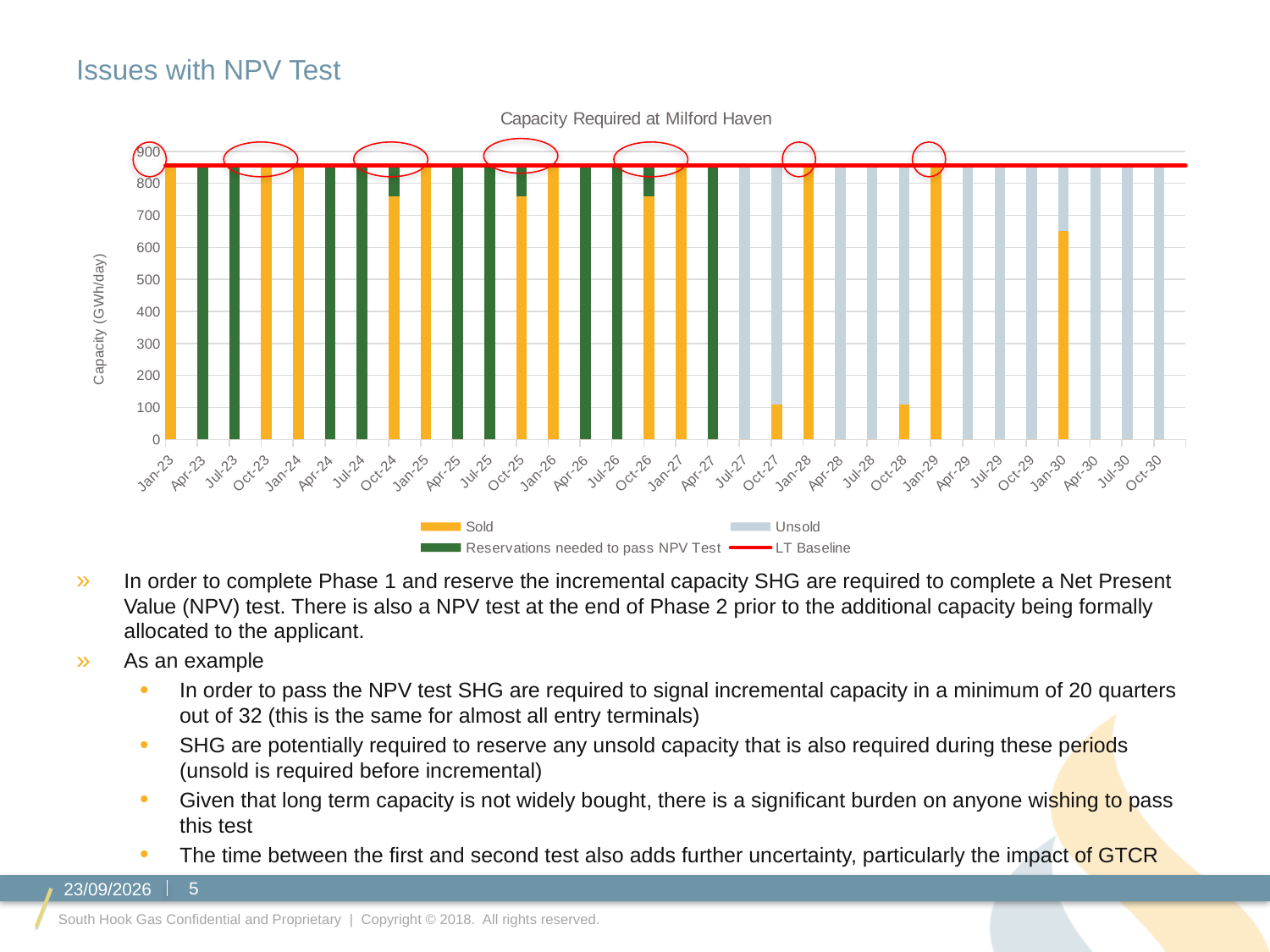
What kind of chart is shown on the slide? Combination bar and line chart (stacked bars with a baseline line) How many entries does the chart legend list? 4 Is the Sold value for Jan-30 greater or less than 600? greater Is the Sold value for Oct-27 greater or less than 200? less What is the label on the y axis of the chart? Capacity (GWh/day) How many quarterly categories are shown on the x axis of the chart? 32 Does the Sold capacity generally rise or fall from Jan-23 to Oct-30? fall Which has the larger Sold value, Jan-30 or Oct-27? Jan-30 Is the Sold value for Jan-23 greater or less than 800? greater What is the title of the chart? Capacity Required at Milford Haven